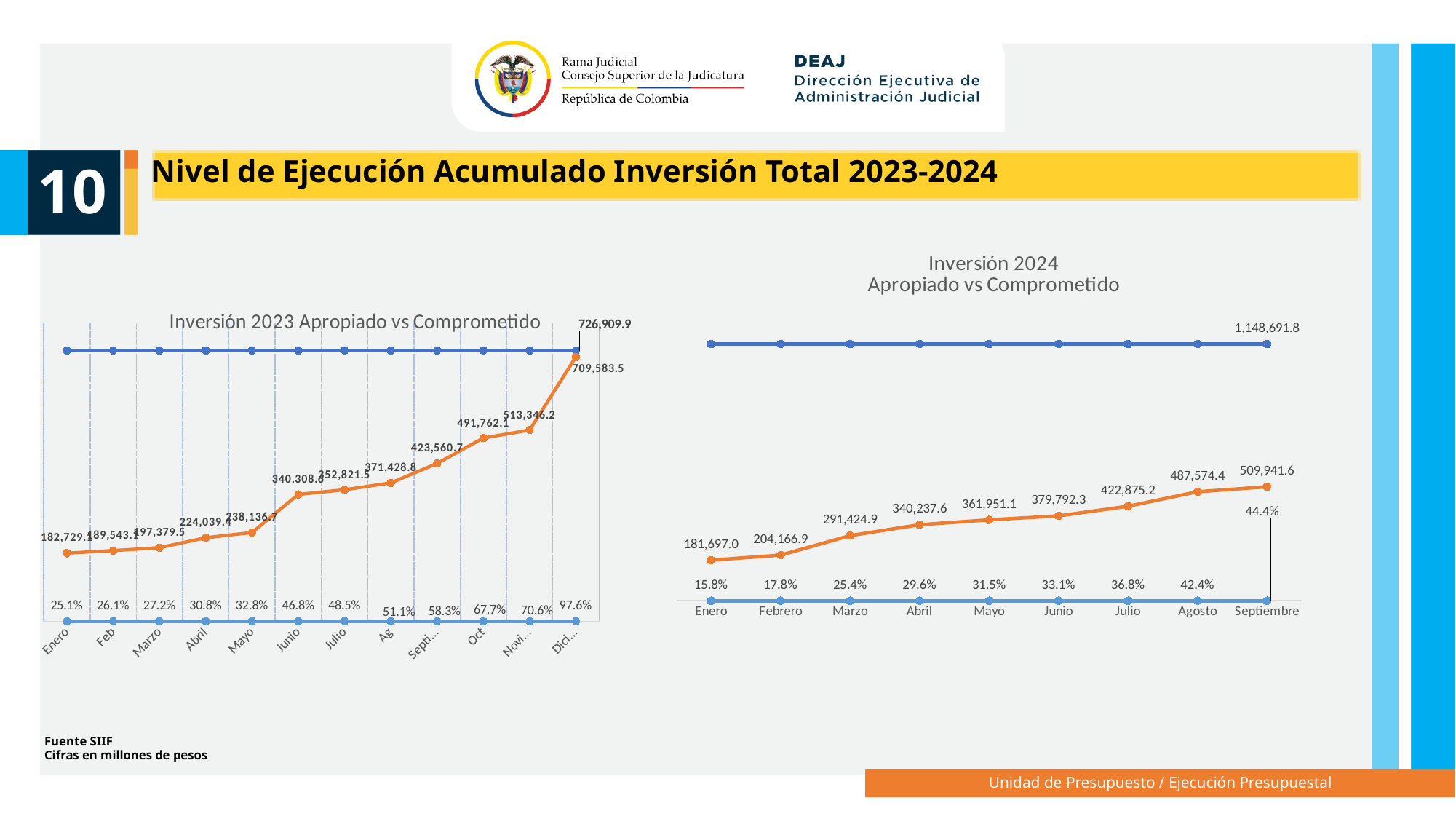
In the 'Inversión 2023 Apropiado vs Comprometido' chart, what is the committed value for Diciembre? 709,583.5 In the 'Inversión 2023 Apropiado vs Comprometido' chart, what is the value of the flat blue appropriated line? 726,909.9 In the 'Inversión 2024 Apropiado vs Comprometido' chart, does the orange committed line rise or fall from Enero to Septiembre? rise What type of chart is the 'Inversión 2024 Apropiado vs Comprometido' chart? line chart In the 'Inversión 2024 Apropiado vs Comprometido' chart, what is the difference between the committed values for Agosto and Julio? 64,699.2 In the 'Inversión 2023 Apropiado vs Comprometido' chart, what execution percentage is shown for Diciembre? 97.6% In the 'Inversión 2023 Apropiado vs Comprometido' chart, which month has the lowest committed value? Enero In the 'Inversión 2023 Apropiado vs Comprometido' chart, which is larger, the committed value for Octubre or for Junio? Octubre In the 'Inversión 2024 Apropiado vs Comprometido' chart, what is the committed (orange line) value for Septiembre? 509,941.6 In the 'Inversión 2024 Apropiado vs Comprometido' chart, what execution percentage is shown for Marzo? 25.4% In the 'Inversión 2024 Apropiado vs Comprometido' chart, what is the value of the flat blue appropriated line? 1,148,691.8 In the 'Inversión 2024 Apropiado vs Comprometido' chart, how many months are shown on the x axis? 9